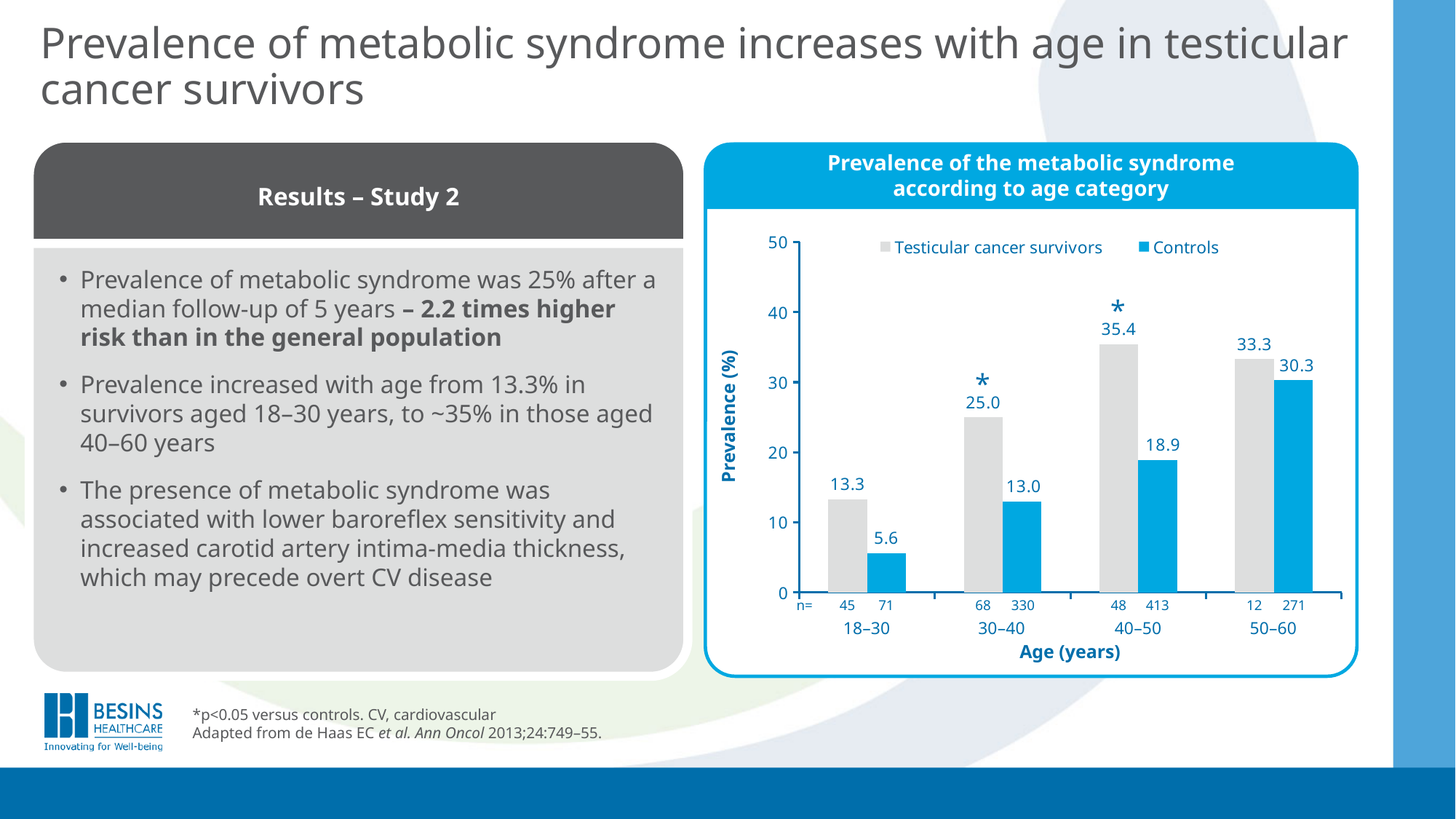
How many age categories are shown on the x axis? 4 Which age category has the highest prevalence among testicular cancer survivors? 40–50 Which is larger in the 30–40 age category: the prevalence in testicular cancer survivors or in controls? Testicular cancer survivors Does the prevalence in controls rise or fall as age category increases along the x axis? Rise What kind of chart is shown on the slide? Bar chart What is the difference in prevalence between testicular cancer survivors and controls in the 40–50 age category? 16.5 How many series does the legend list? 2 What is the prevalence of metabolic syndrome in controls aged 30–40 years? 13.0 What is the label of the y axis of the chart? Prevalence (%) What is the prevalence of metabolic syndrome in controls aged 50–60 years? 30.3 What is the prevalence of metabolic syndrome in testicular cancer survivors aged 18–30 years? 13.3 Which age category has the lowest prevalence among controls? 18–30